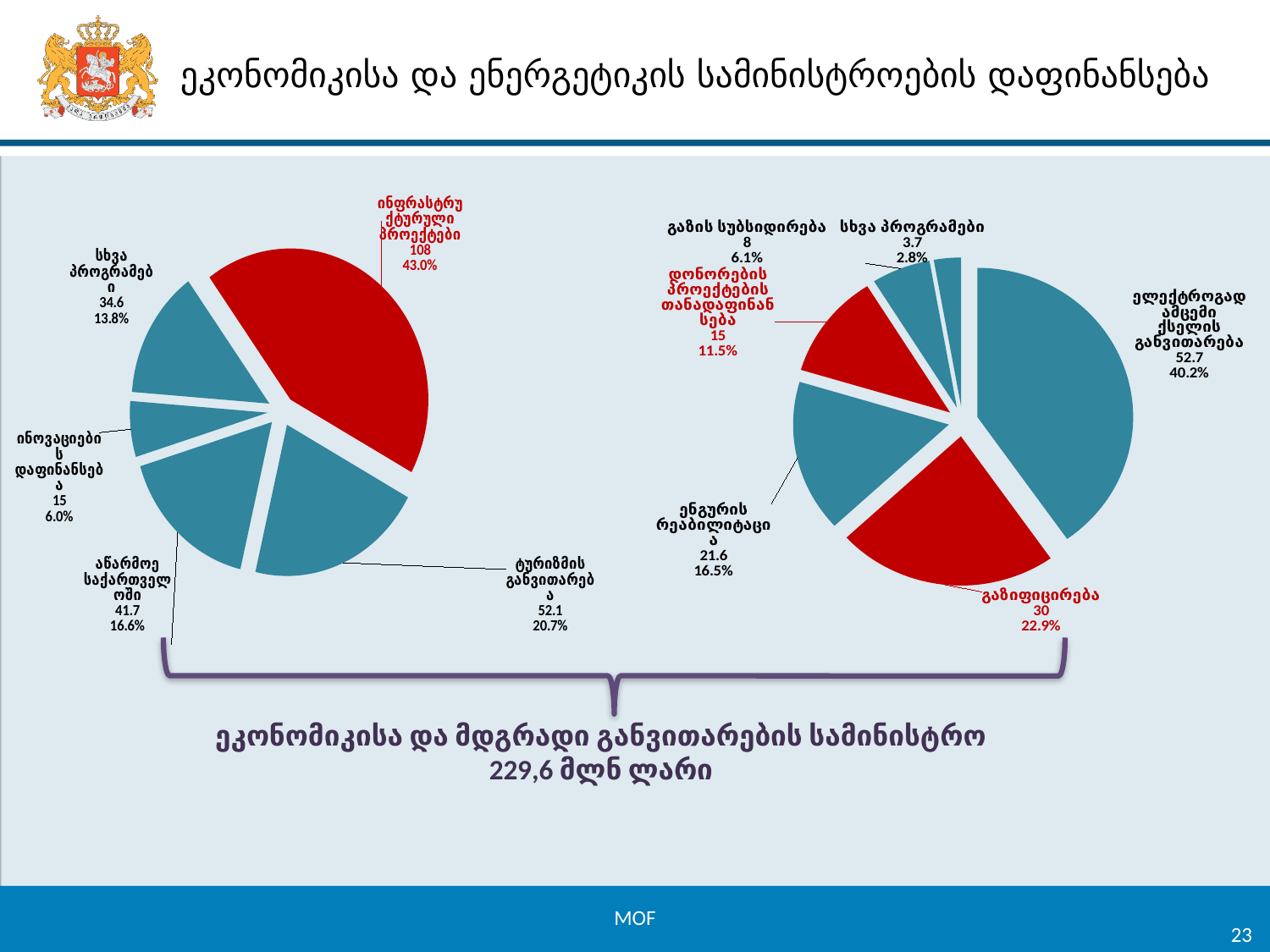
On the right pie chart, what value is shown for გაზიფიცირება? 30 On the left pie chart, what value is shown for ინფრასტრუქტურული პროექტები? 108 On the left pie chart, what is the difference between the values for ტურიზმის განვითარება and აწარმოე საქართველოში? 10.4 On the left pie chart, which category has the largest slice? ინფრასტრუქტურული პროექტები How many slices does the right pie chart have? 6 On the right pie chart, what share does ელექტროგადამცემი ქსელის განვითარება have? 40.2% On the right pie chart, which category has the smallest slice? სხვა პროგრამები On the right pie chart, which is larger: ენგურის რეაბილიტაცია or დონორების პროექტების თანადაფინანსება? ენგურის რეაბილიტაცია How many slices does the left pie chart have? 5 What type of chart is shown on the left of the slide? Pie chart On the left pie chart, what share does ტურიზმის განვითარება have? 20.7% On the left pie chart, which category has the smallest slice? ინოვაციების დაფინანსება